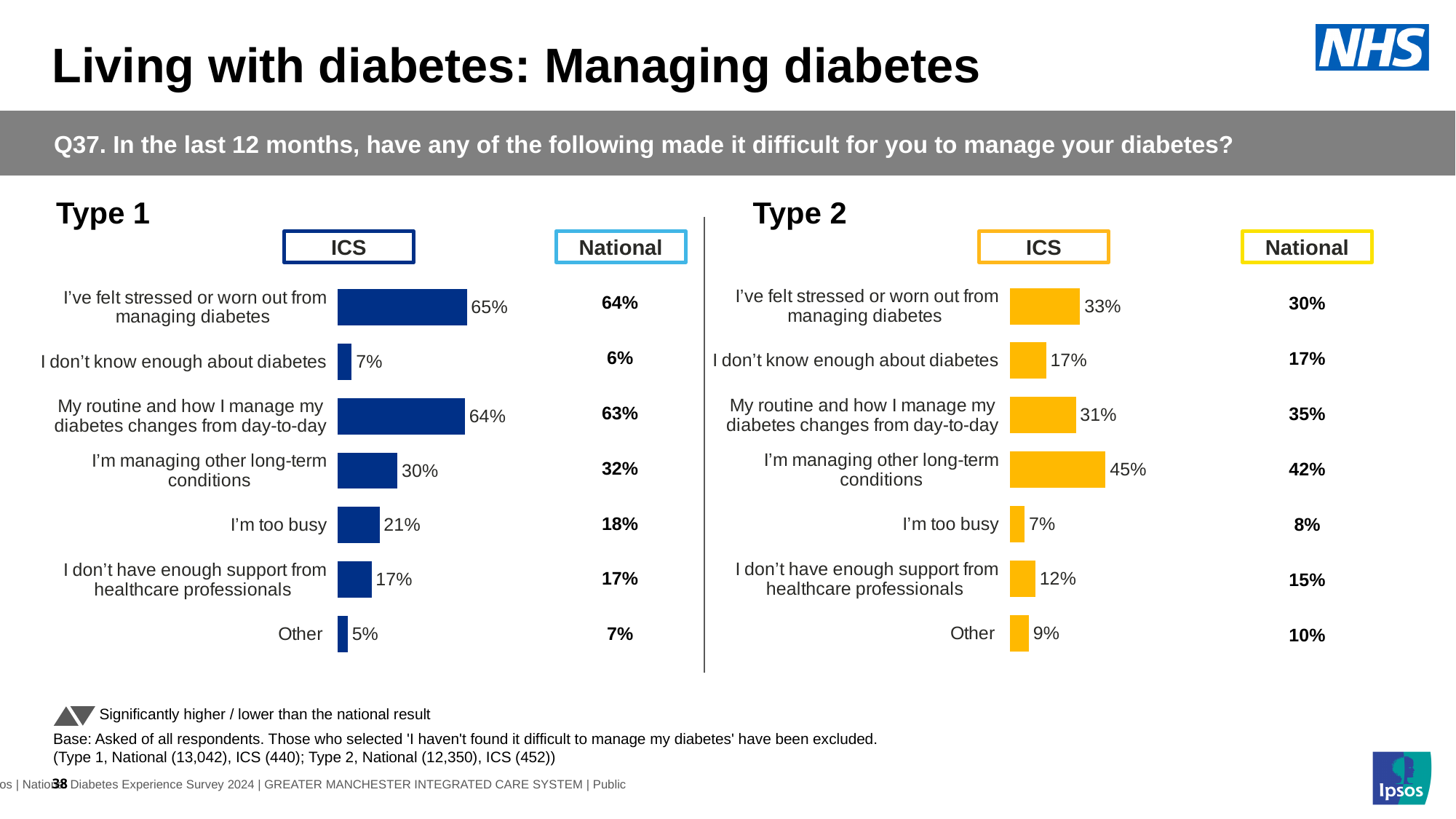
What colour are the bars in the Type 2 chart? Yellow What kind of chart is used to show the ICS values for Type 1 and Type 2? Bar chart In the Type 2 chart, what is the ICS value for 'I'm managing other long-term conditions'? 45% In the Type 2 chart, which is larger for 'I don't have enough support from healthcare professionals': the ICS value or the National value? National In the Type 1 chart, what is the National value for 'I'm too busy'? 18% In the Type 1 chart, which category has the highest ICS value? I've felt stressed or worn out from managing diabetes In the Type 2 chart, what is the National value for 'My routine and how I manage my diabetes changes from day-to-day'? 35% In the Type 1 chart, what is the difference between the ICS and National values for 'I'm too busy'? 3 percentage points In the Type 1 chart, what is the ICS value for 'I've felt stressed or worn out from managing diabetes'? 65% How many categories are shown in the Type 1 chart? 7 In the Type 2 chart, what is the difference between the ICS values for 'I'm managing other long-term conditions' and 'I've felt stressed or worn out from managing diabetes'? 12 percentage points In the Type 2 chart, which category has the lowest ICS value? I'm too busy